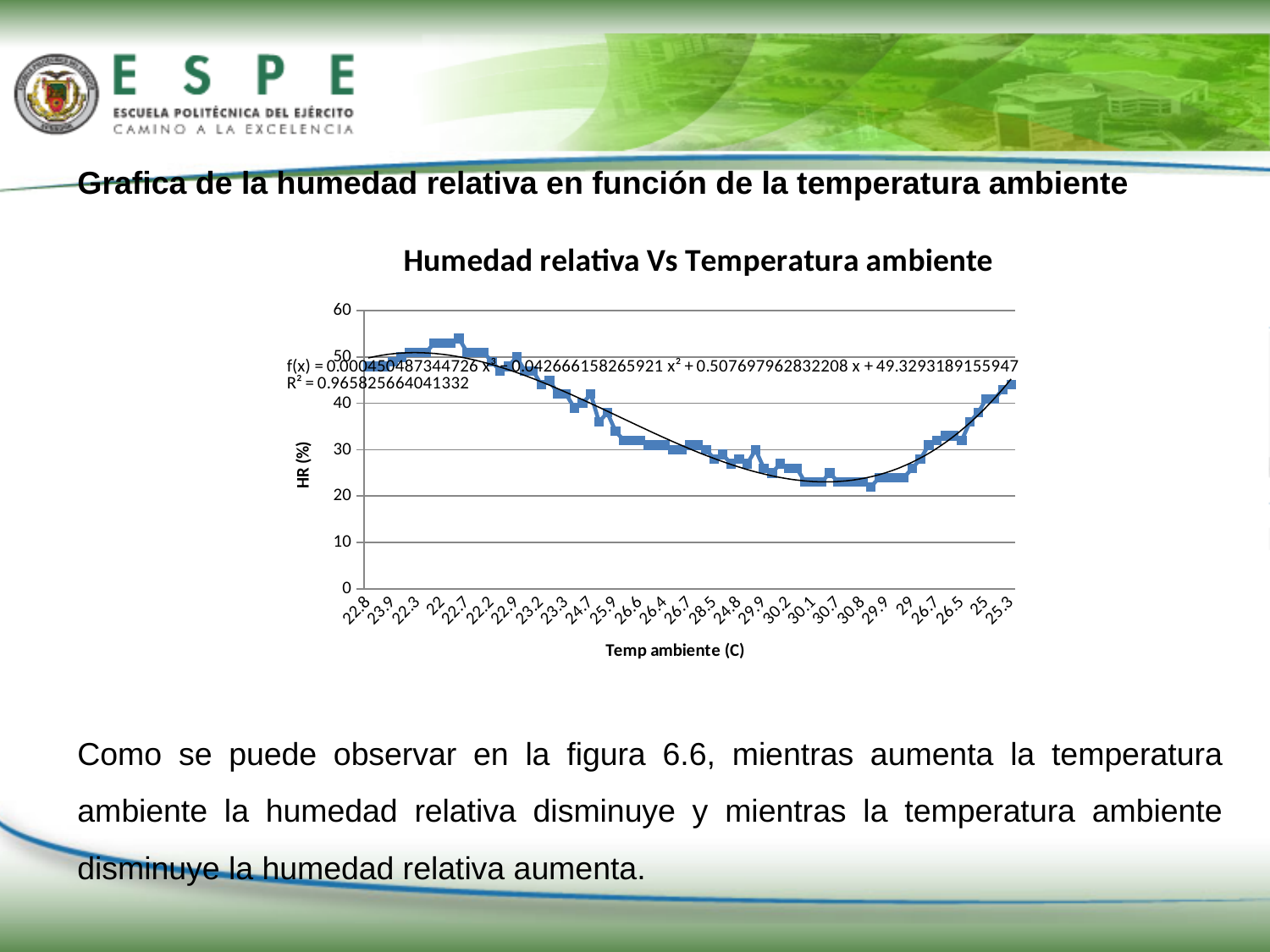
What kind of chart is shown on the slide? line chart Do the HR (%) values rise or fall along the x axis from the label 22.8 to the label 30.1? fall What is the title of the chart? Humedad relativa Vs Temperatura ambiente What is the highest tick value shown on the vertical axis of the chart? 60 Is the HR (%) value at the x-axis label 30.1 greater or less than 30? less What R² value is printed on the chart for the fitted curve? 0.965825664041332 Is the HR (%) value at the first x-axis label, 22.8, greater or less than 40? greater Is the HR (%) value at the last x-axis label, 25.3, greater or less than 40? greater Do the HR (%) values rise or fall along the x axis from the label 30.8 to the label 25.3? rise What is the label of the vertical axis of the chart? HR (%)